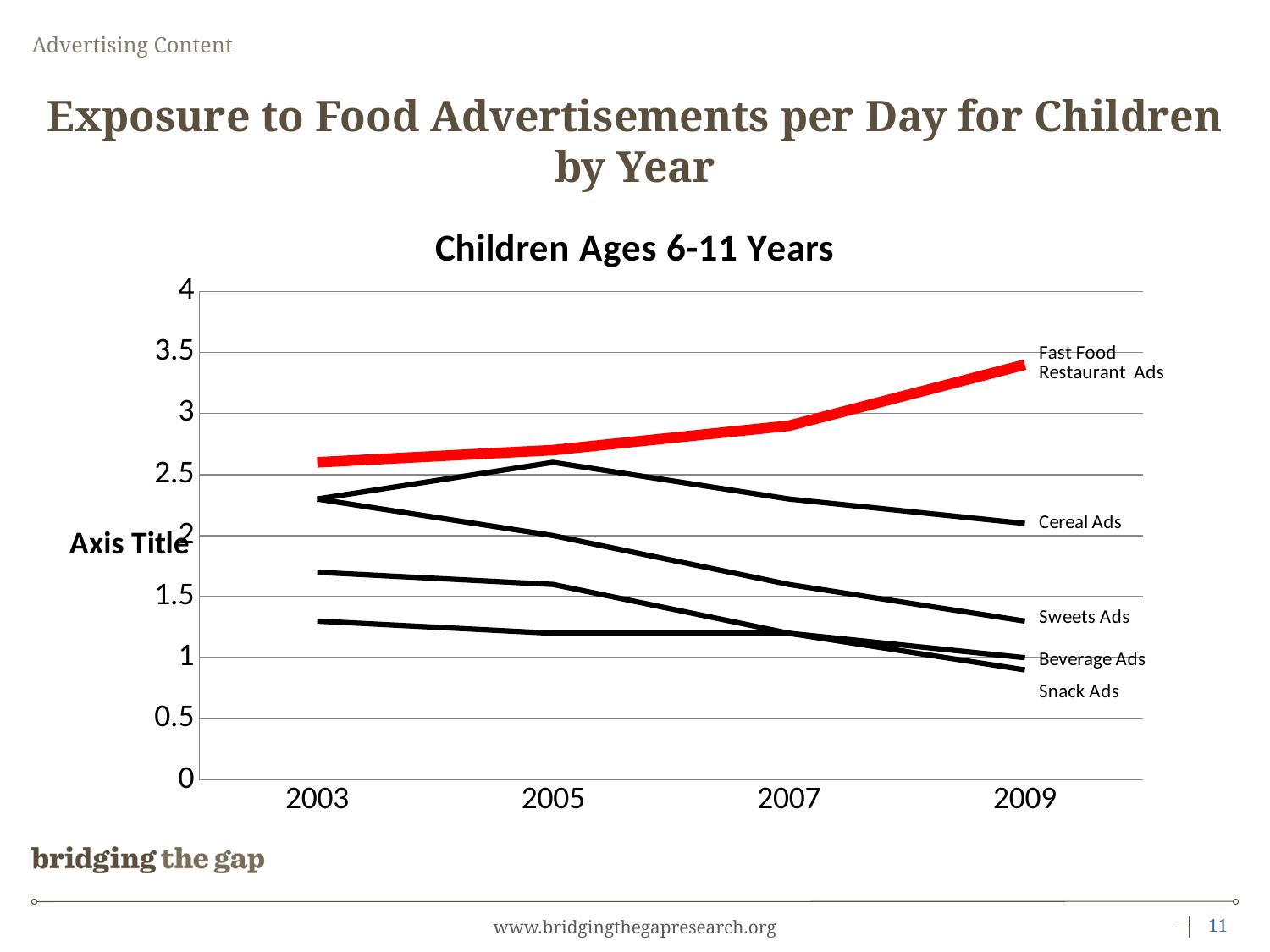
Which series is drawn in red? Fast Food Restaurant Ads How many years are shown on the x axis? 4 Is the value for Fast Food Restaurant Ads in 2009 greater or less than 3? greater How many series are plotted in the chart? 5 What kind of chart is shown on the slide? line chart Do the values for Fast Food Restaurant Ads rise or fall from 2003 to 2009? rise Which is larger in 2009, Cereal Ads or Sweets Ads? Cereal Ads Do the values for Sweets Ads rise or fall from 2003 to 2009? fall Which series has the highest value in 2003? Fast Food Restaurant Ads Which series has the highest value in 2009? Fast Food Restaurant Ads Is the value for Fast Food Restaurant Ads in 2003 greater or less than 2? greater Is the value for Sweets Ads in 2009 greater or less than 1.5? less